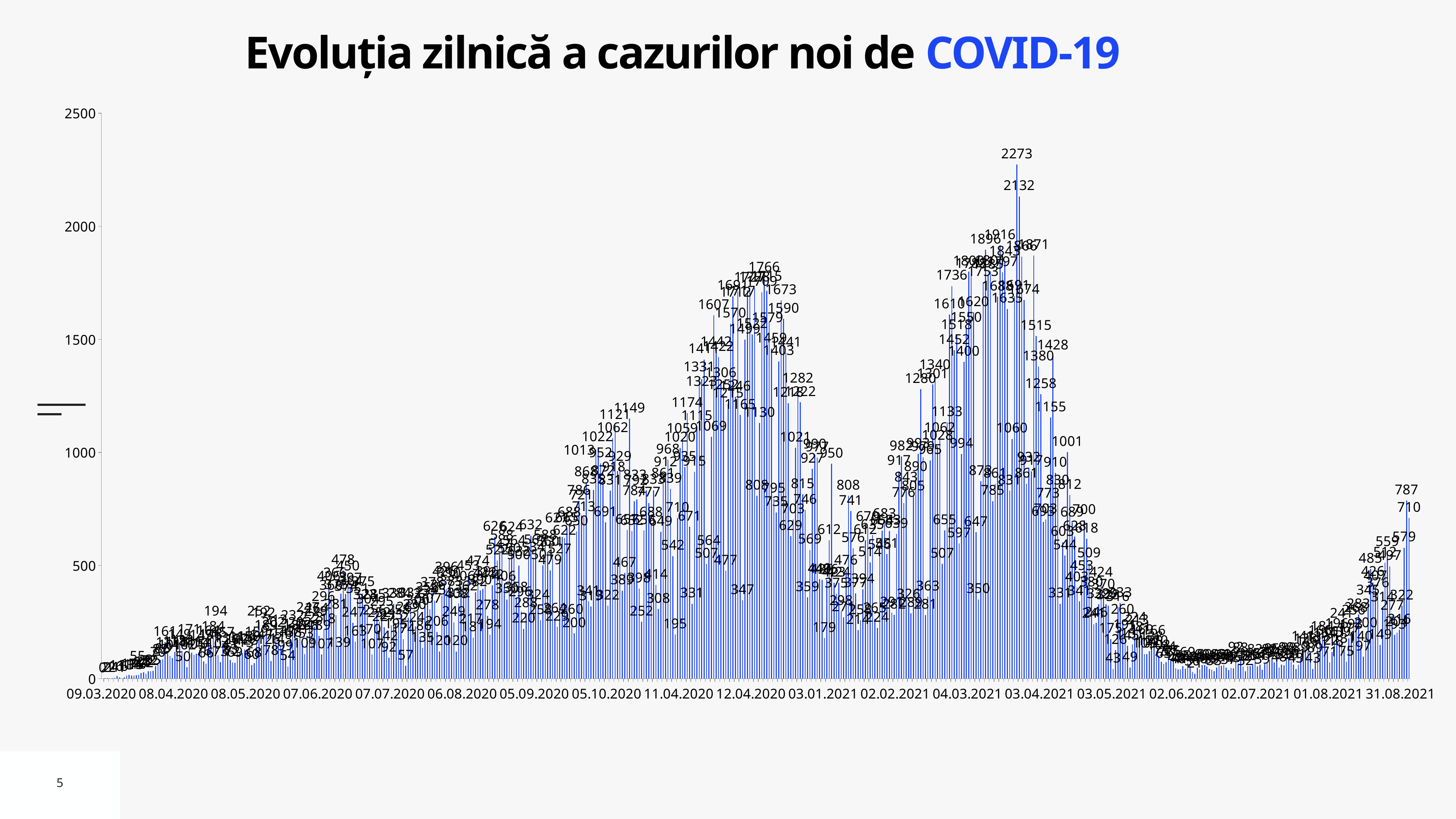
Do the values rise or fall between the 03.05.2021 and 02.06.2021 axis labels? fall What is the title of the chart? Evoluția zilnică a cazurilor noi de COVID-19 What kind of chart is shown on the slide? bar chart What is the last date label on the horizontal axis? 31.08.2021 Which is larger: the peak of 2273 around April 2021 or the peak of 1766 around December 2020? 2273 What is the second-highest daily value labelled on the chart, next to the 2273 peak? 2132 What is the highest daily value labelled on the chart? 2273 Is the highest bar on the chart greater or less than 2000? greater Do the values rise or fall between the 01.08.2021 and 31.08.2021 axis labels? rise What is the first date label on the horizontal axis? 09.03.2020 What is the difference between the two highest labelled values, 2273 and 2132? 141 What is the maximum value shown on the vertical axis? 2500